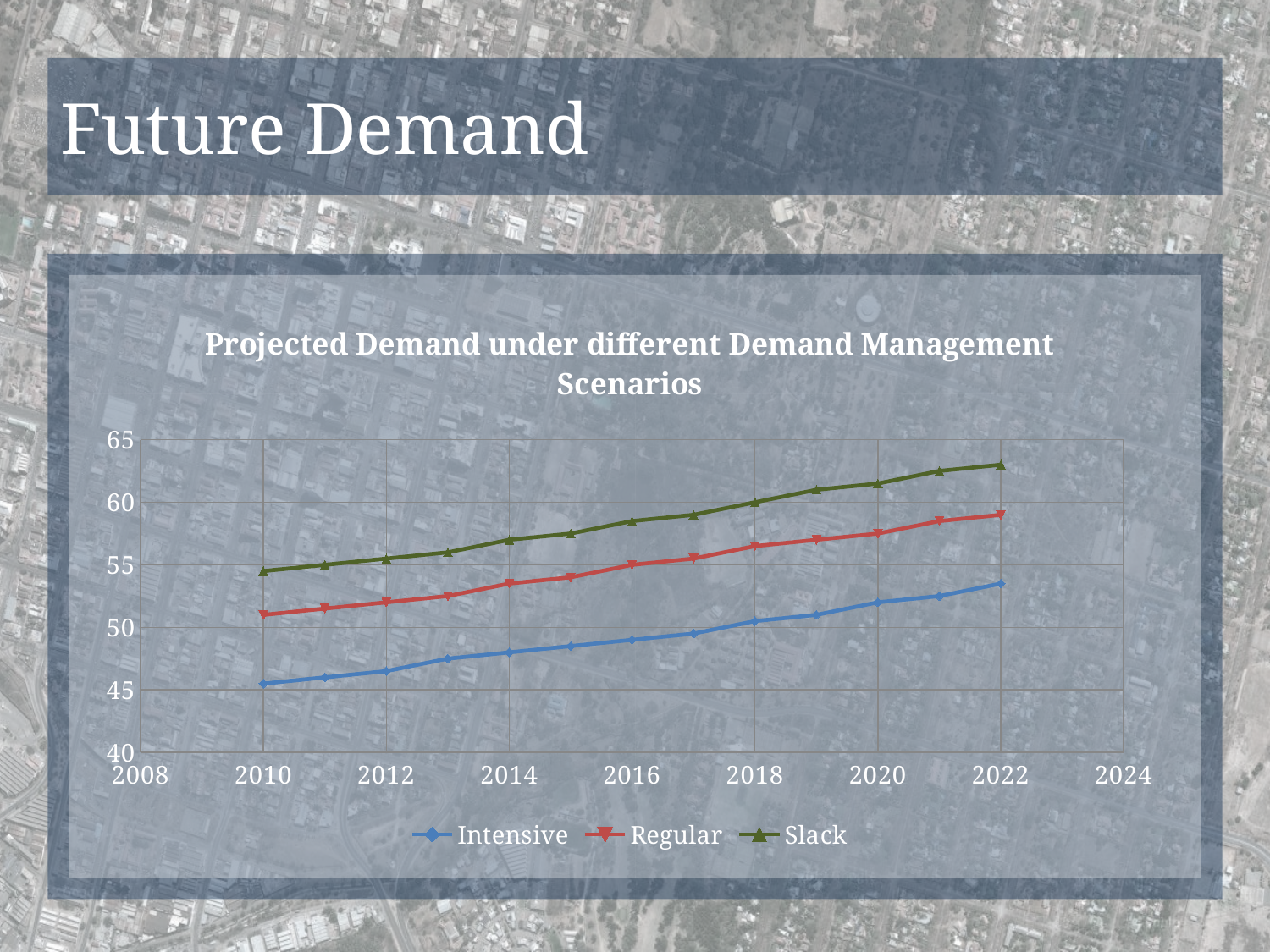
What is the title of the chart? Projected Demand under different Demand Management Scenarios Is the value for Slack in 2016 greater or less than 55? greater Is the value for Intensive in 2010 greater or less than 50? less Which series has the lowest values throughout the chart? Intensive How many series does the legend list? 3 Which series has the highest values throughout the chart? Slack How many data points are plotted for each series? 13 What kind of chart is shown on the slide? line chart Which is larger in 2022, the value for Slack or the value for Intensive? Slack Do the values for the Intensive series rise or fall from 2010 to 2022? rise Is the value for Slack in 2022 greater or less than 60? greater